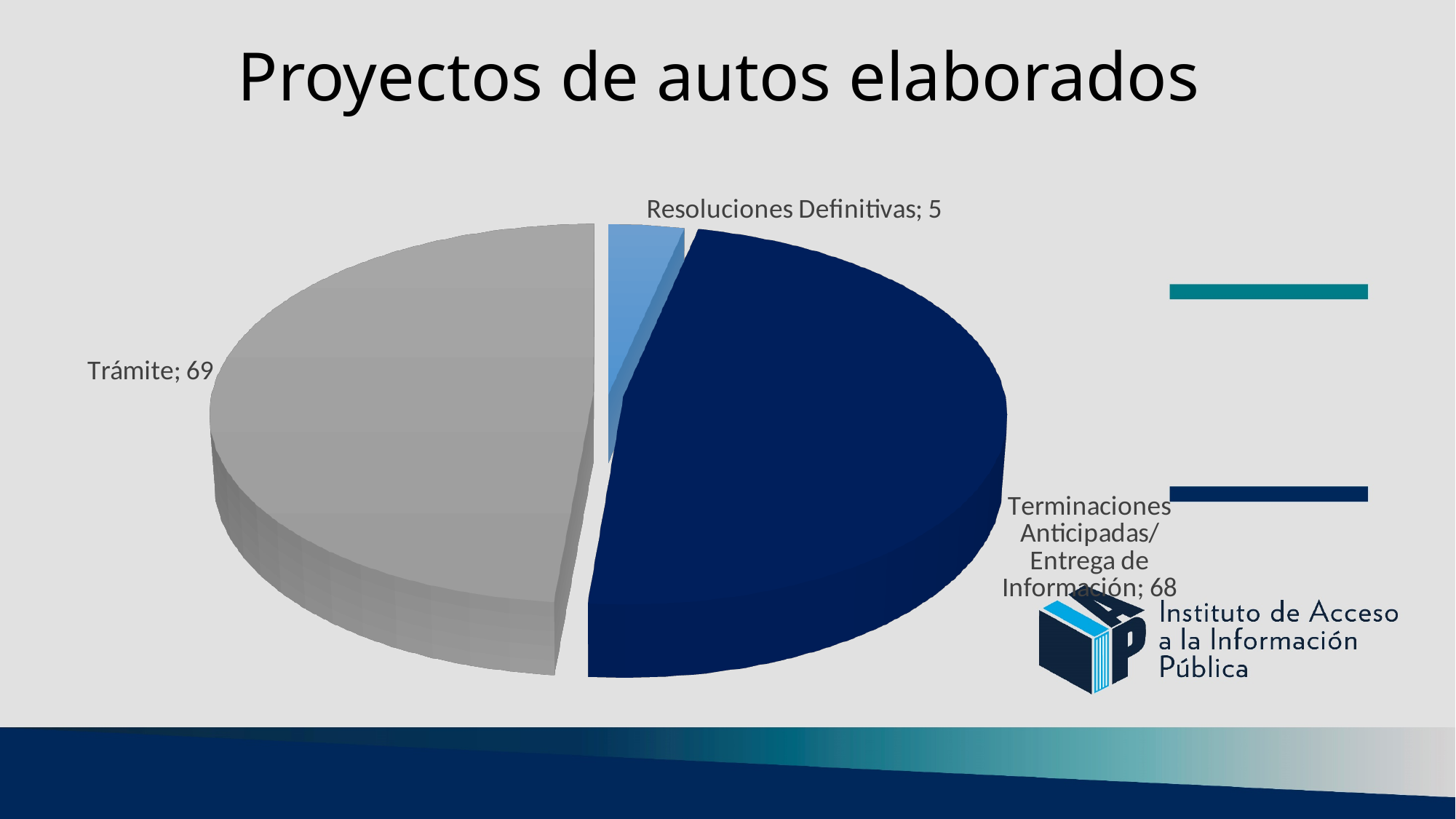
What is the title of the chart? Proyectos de autos elaborados What is the difference between the values for Trámite and Resoluciones Definitivas? 64 What is the difference between the values for Terminaciones Anticipadas/Entrega de Información and Resoluciones Definitivas? 63 Which category has the largest value? Trámite What is the value for Terminaciones Anticipadas/Entrega de Información? 68 What colour is the Trámite slice? Grey Which is larger, Trámite or Resoluciones Definitivas? Trámite What is the value for Trámite? 69 Which category has the smallest value? Resoluciones Definitivas What type of chart is shown on the slide? Pie chart What is the value for Resoluciones Definitivas? 5 How many slices does the pie chart have? 3